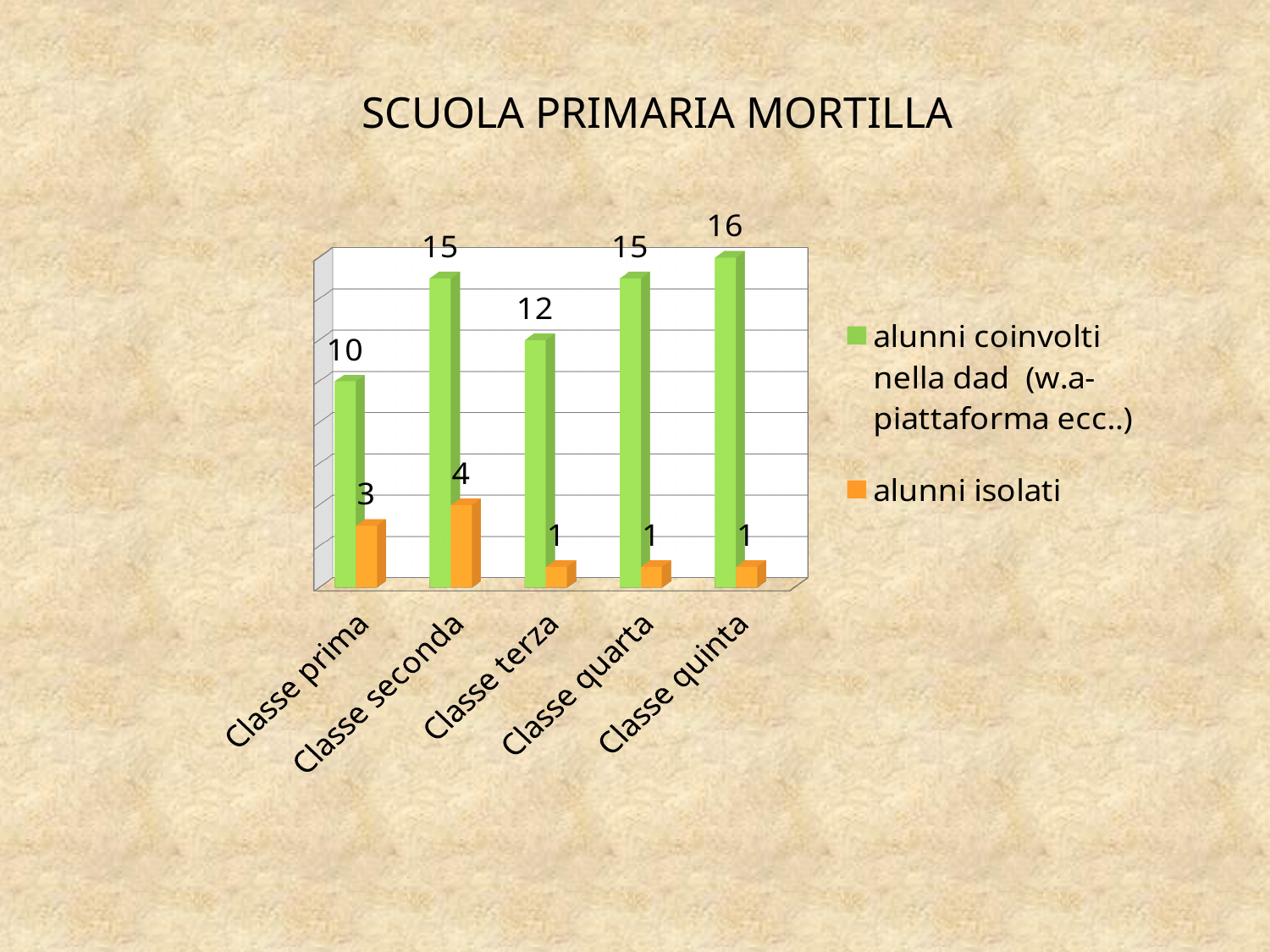
What is the difference between 'alunni coinvolti nella dad' and 'alunni isolati' for Classe quinta? 15 How many series does the legend list? 2 What kind of chart is shown on the slide? Bar chart Which is larger: 'alunni coinvolti nella dad' for Classe seconda or for Classe terza? Classe seconda Which class has the lowest value for 'alunni coinvolti nella dad (w.a-piattaforma ecc..)'? Classe prima Which class has the highest value for 'alunni isolati'? Classe seconda How many classes are shown on the x axis? 5 What is the value of 'alunni isolati' for Classe seconda? 4 What is the value of 'alunni coinvolti nella dad (w.a-piattaforma ecc..)' for Classe prima? 10 Which class has the highest value for 'alunni coinvolti nella dad (w.a-piattaforma ecc..)'? Classe quinta What is the value of 'alunni coinvolti nella dad (w.a-piattaforma ecc..)' for Classe terza? 12 What is the difference in 'alunni isolati' between Classe prima and Classe terza? 2